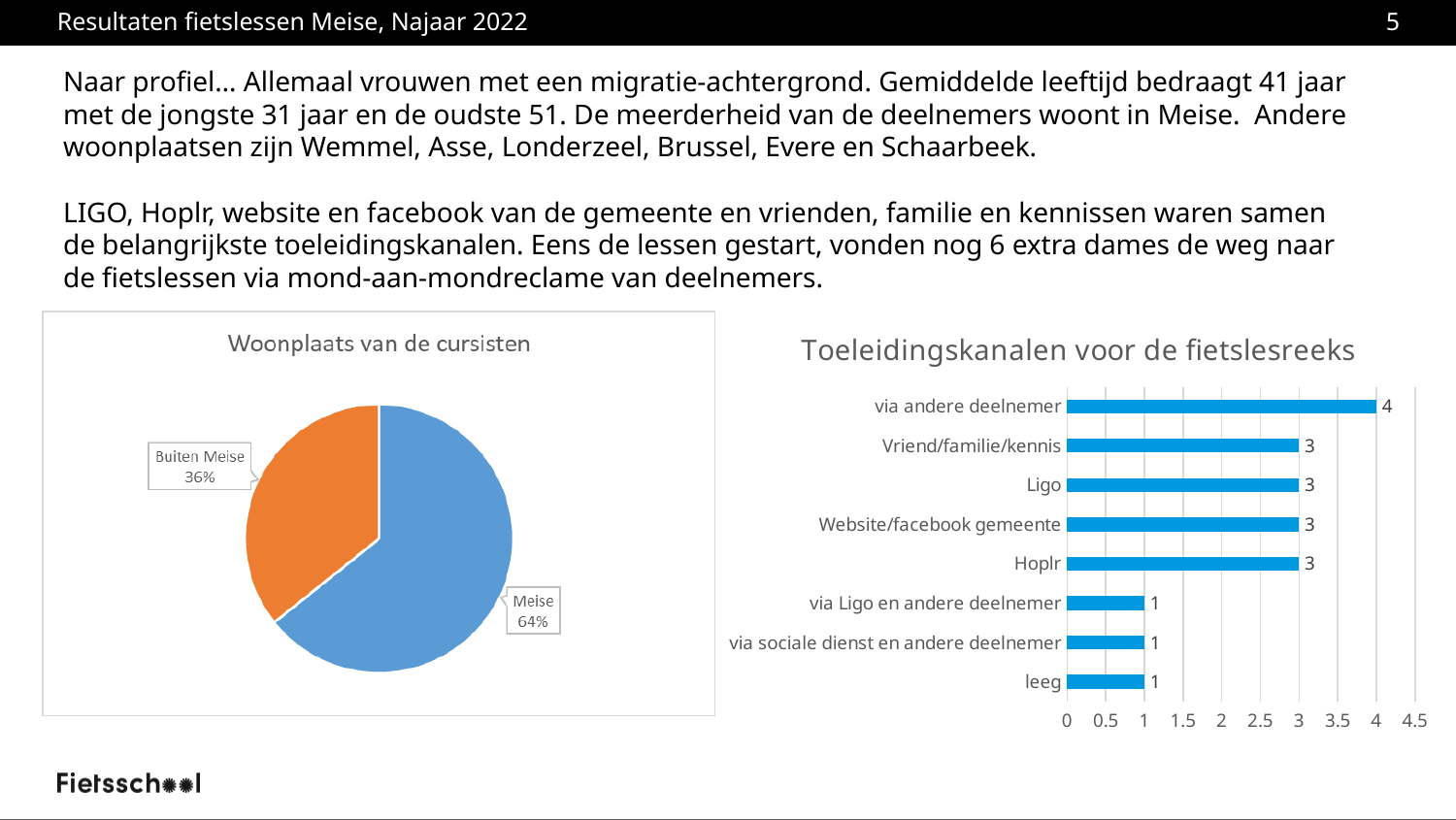
In the 'Woonplaats van de cursisten' chart, what is the difference in percentage points between Meise and Buiten Meise? 28 What kind of chart is 'Woonplaats van de cursisten'? Pie chart In the 'Toeleidingskanalen voor de fietslesreeks' chart, what is the value for Hoplr? 3 In the 'Toeleidingskanalen voor de fietslesreeks' chart, which category has the highest value? via andere deelnemer In the 'Toeleidingskanalen voor de fietslesreeks' chart, which is larger, the value for Ligo or the value for leeg? Ligo In the 'Woonplaats van de cursisten' chart, what share of the pie is Meise? 64% In the 'Toeleidingskanalen voor de fietslesreeks' chart, what is the difference between 'via andere deelnemer' and Ligo? 1 How many categories are shown in the 'Toeleidingskanalen voor de fietslesreeks' chart? 8 In the 'Toeleidingskanalen voor de fietslesreeks' chart, what is the value for 'via andere deelnemer'? 4 What kind of chart is 'Toeleidingskanalen voor de fietslesreeks'? Bar chart In the 'Woonplaats van de cursisten' chart, which slice is larger, Meise or Buiten Meise? Meise In the 'Woonplaats van de cursisten' chart, what share of the pie is Buiten Meise? 36%